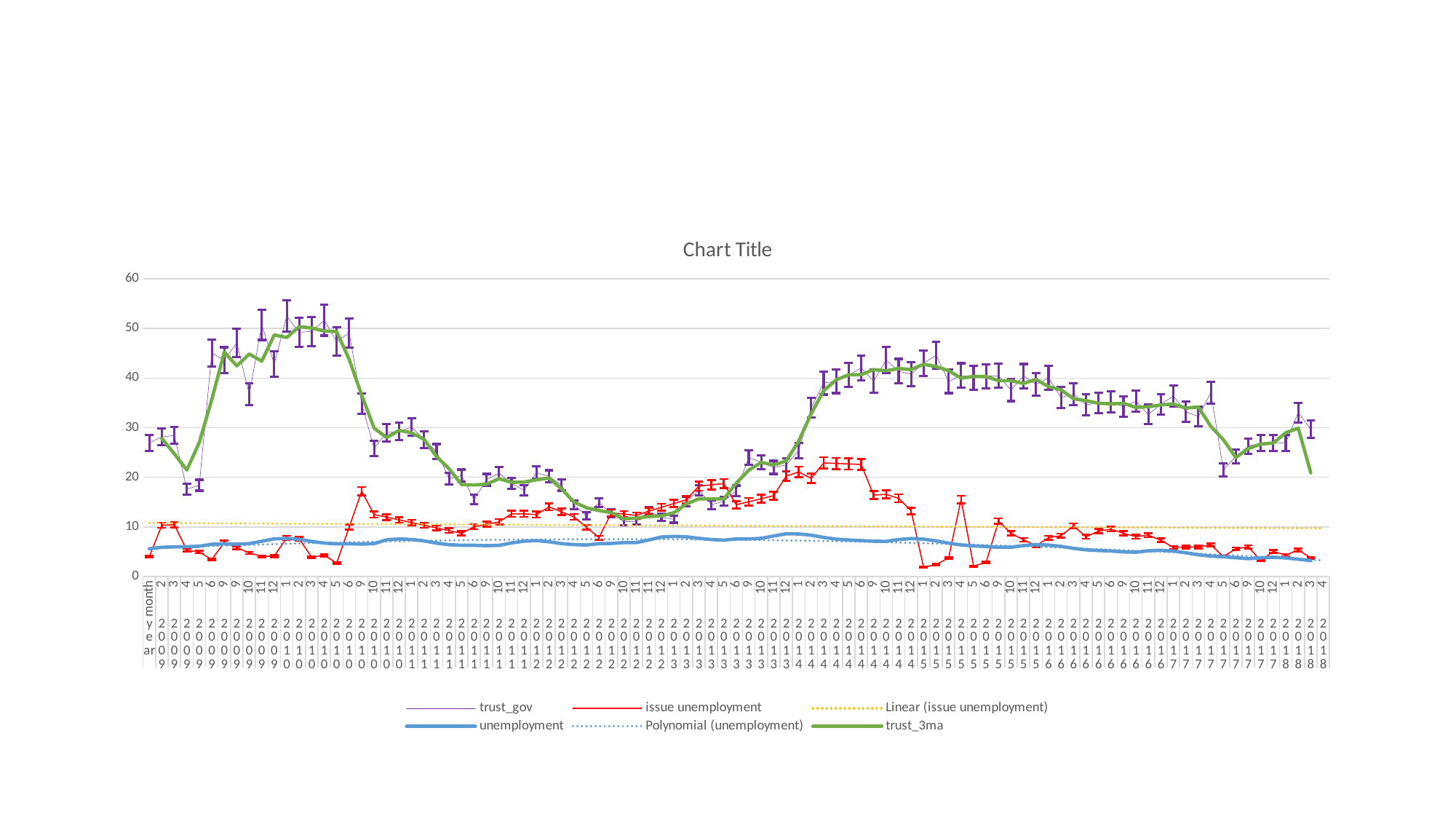
Is the value of trust_gov for month 2 of 2010 greater or less than 40? greater Which is larger at month 2 of 2010: the value of trust_gov or the value of unemployment? trust_gov What kind of chart is shown on the slide? line chart Is the value of issue unemployment for month 9 of 2010 greater or less than 10? greater Is the value of trust_gov for month 10 of 2011 greater or less than 30? less Does the trust_3ma series rise or fall between month 10 of 2012 and month 1 of 2014? rise Does the trust_gov series rise or fall between month 2 of 2010 and month 10 of 2011? fall What is the title of the chart? Chart Title Which series is drawn as the thick green line? trust_3ma How many series does the legend list? 6